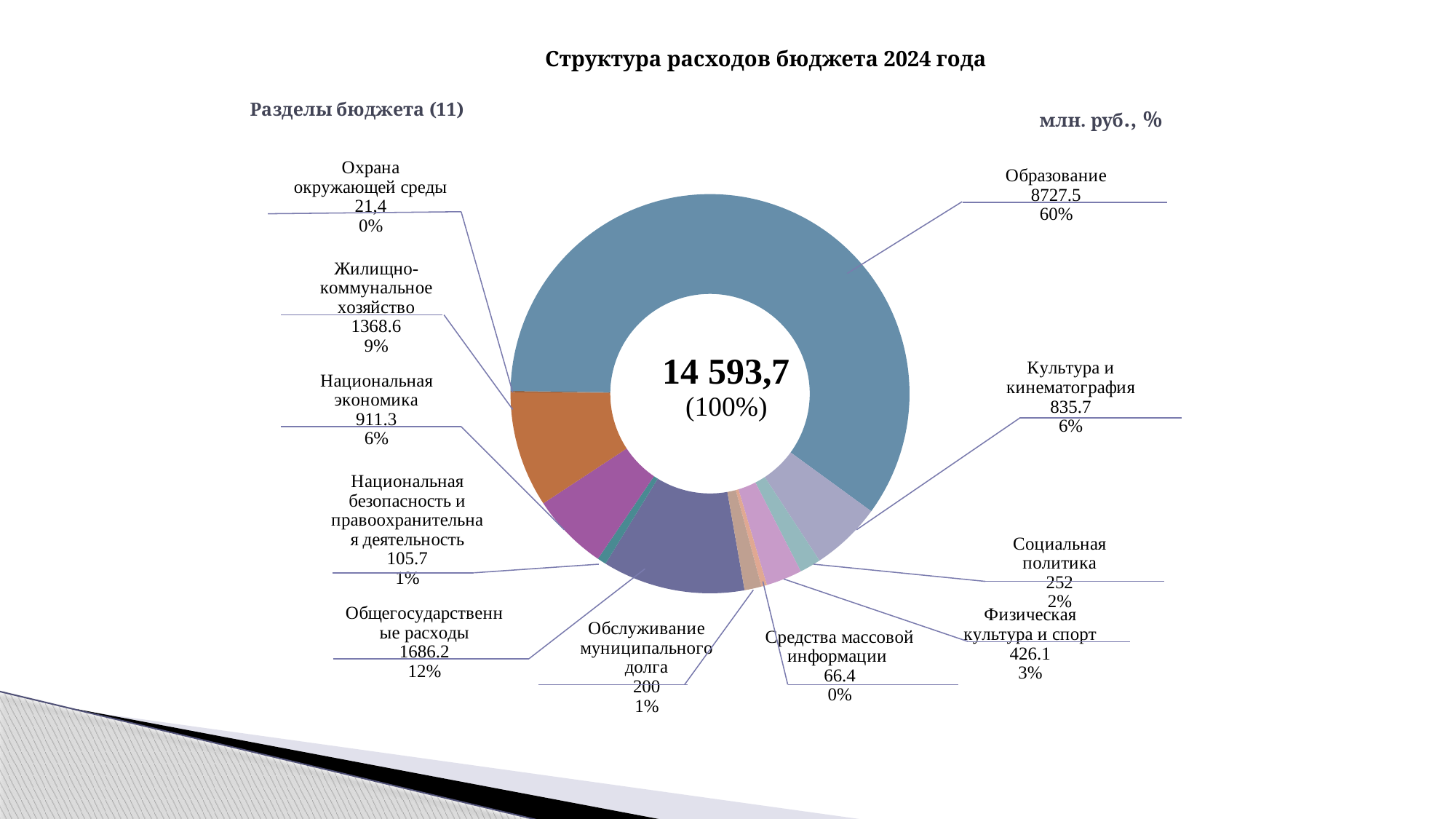
What is the title of the chart? Разделы бюджета (11) What is the value for Общегосударственные расходы? 1686.2 How many budget sections are shown in the chart? 11 What is the value for Жилищно-коммунальное хозяйство? 1368.6 Which budget section has the smallest value? Охрана окружающей среды What is the difference between Общегосударственные расходы and Жилищно-коммунальное хозяйство? 317.6 What type of chart is shown on the slide? Donut (pie) chart Which budget section has the largest value? Образование What is the value for Образование in the chart? 8727.5 What is the total value shown in the centre of the chart? 14 593,7 Which is larger: Национальная экономика or Культура и кинематография? Национальная экономика What share of the budget does Образование account for? 60%